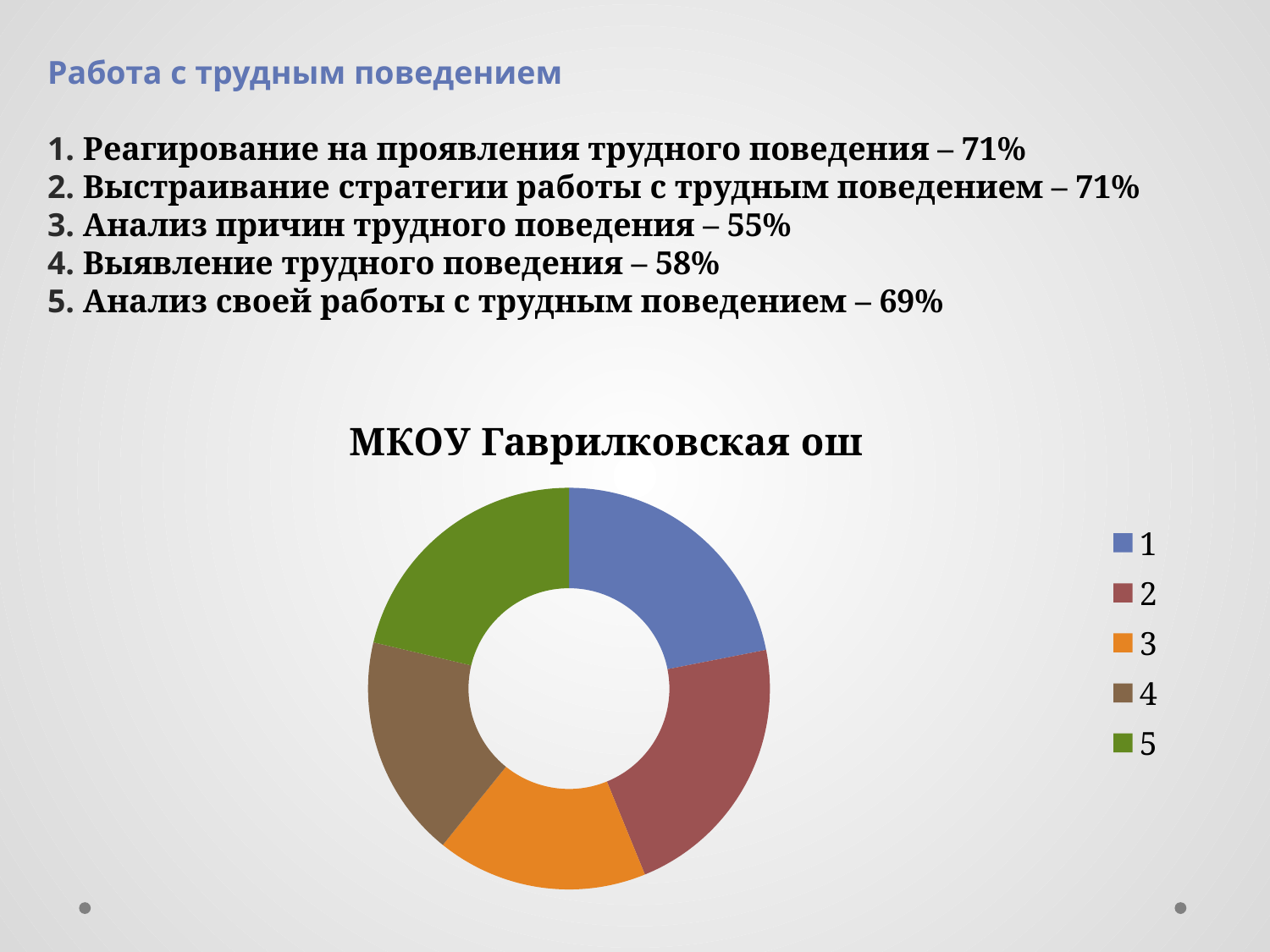
According to the slide, what is the value for category 5 (Анализ своей работы с трудным поведением)? 69% According to the slide, what is the value for category 1 (Реагирование на проявления трудного поведения)? 71% How many categories does the doughnut chart have? 5 What is the difference between the value for category 2 (71%) and the value for category 3 (55%)? 16% According to the slide, what is the value for category 3 (Анализ причин трудного поведения)? 55% Which colour represents category 5 in the doughnut chart? green According to the slide, what is the value for category 4 (Выявление трудного поведения)? 58% What is the title of the chart? МКОУ Гаврилковская ош What kind of chart is shown on the slide? doughnut chart Which is larger, the value for category 1 or the value for category 3? category 1 How many entries does the chart legend list? 5